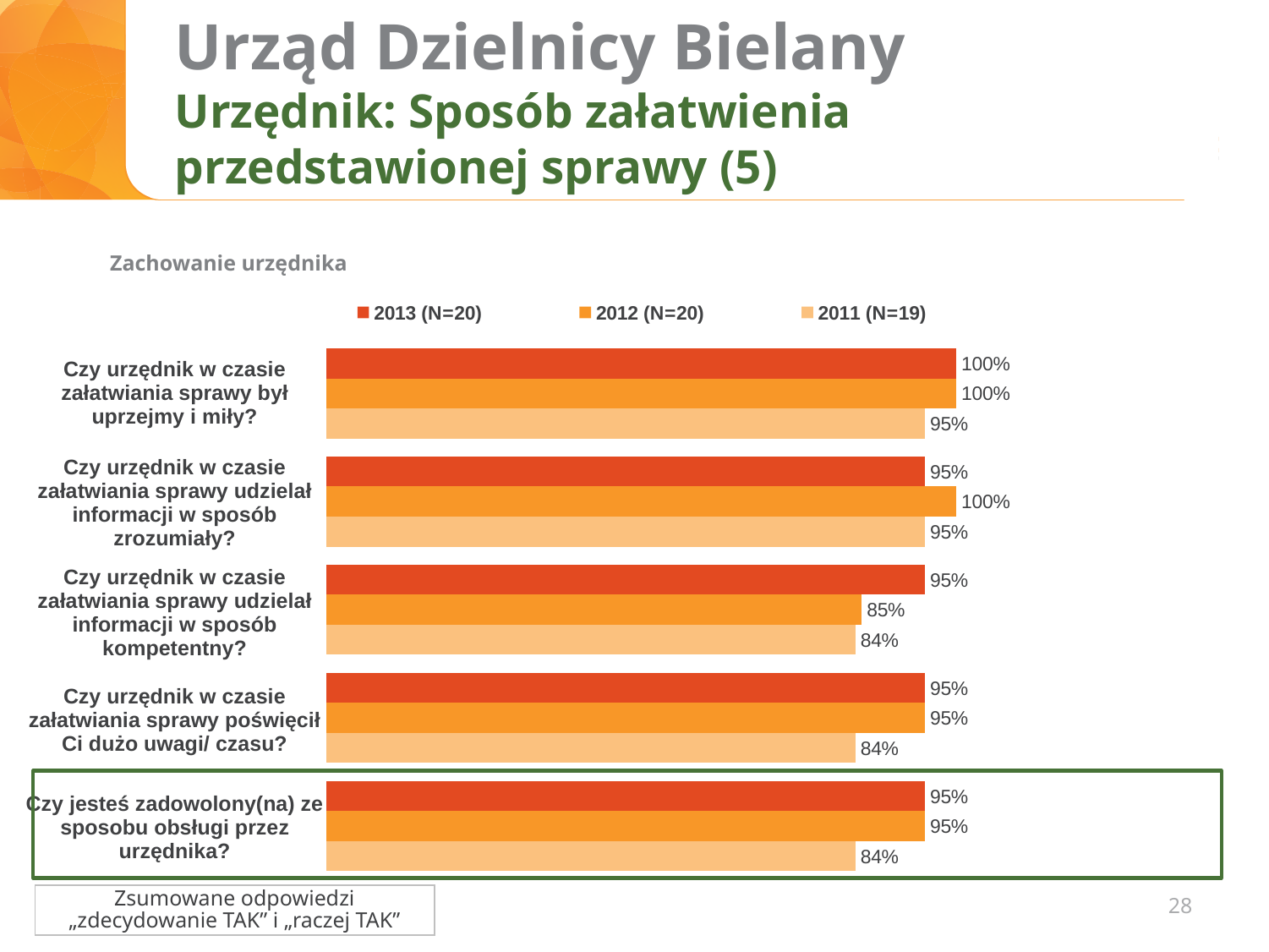
How many series does the legend list? 3 What type of chart is shown on the slide? bar chart What is the title of the chart? Zachowanie urzędnika Which year has the lowest value for "Czy urzędnik w czasie załatwiania sprawy poświęcił Ci dużo uwagi/ czasu?"? 2011 (N=19) How many question categories are plotted in the chart? 5 What is the difference between the 2013 (N=20) and 2012 (N=20) values for "Czy urzędnik w czasie załatwiania sprawy udzielał informacji w sposób kompetentny?"? 10 percentage points What is the 2011 (N=19) value for "Czy urzędnik w czasie załatwiania sprawy udzielał informacji w sposób kompetentny?"? 84% For "Czy urzędnik w czasie załatwiania sprawy udzielał informacji w sposób zrozumiały?", which is larger: the 2012 (N=20) value or the 2013 (N=20) value? 2012 (N=20) What is the 2012 (N=20) value for "Czy jesteś zadowolony(na) ze sposobu obsługi przez urzędnika?"? 95% What is the 2012 (N=20) value for "Czy urzędnik w czasie załatwiania sprawy udzielał informacji w sposób zrozumiały?"? 100% What is the 2013 (N=20) value for "Czy urzędnik w czasie załatwiania sprawy był uprzejmy i miły?"? 100% What is the difference between the 2013 (N=20) and 2011 (N=19) values for "Czy jesteś zadowolony(na) ze sposobu obsługi przez urzędnika?"? 11 percentage points